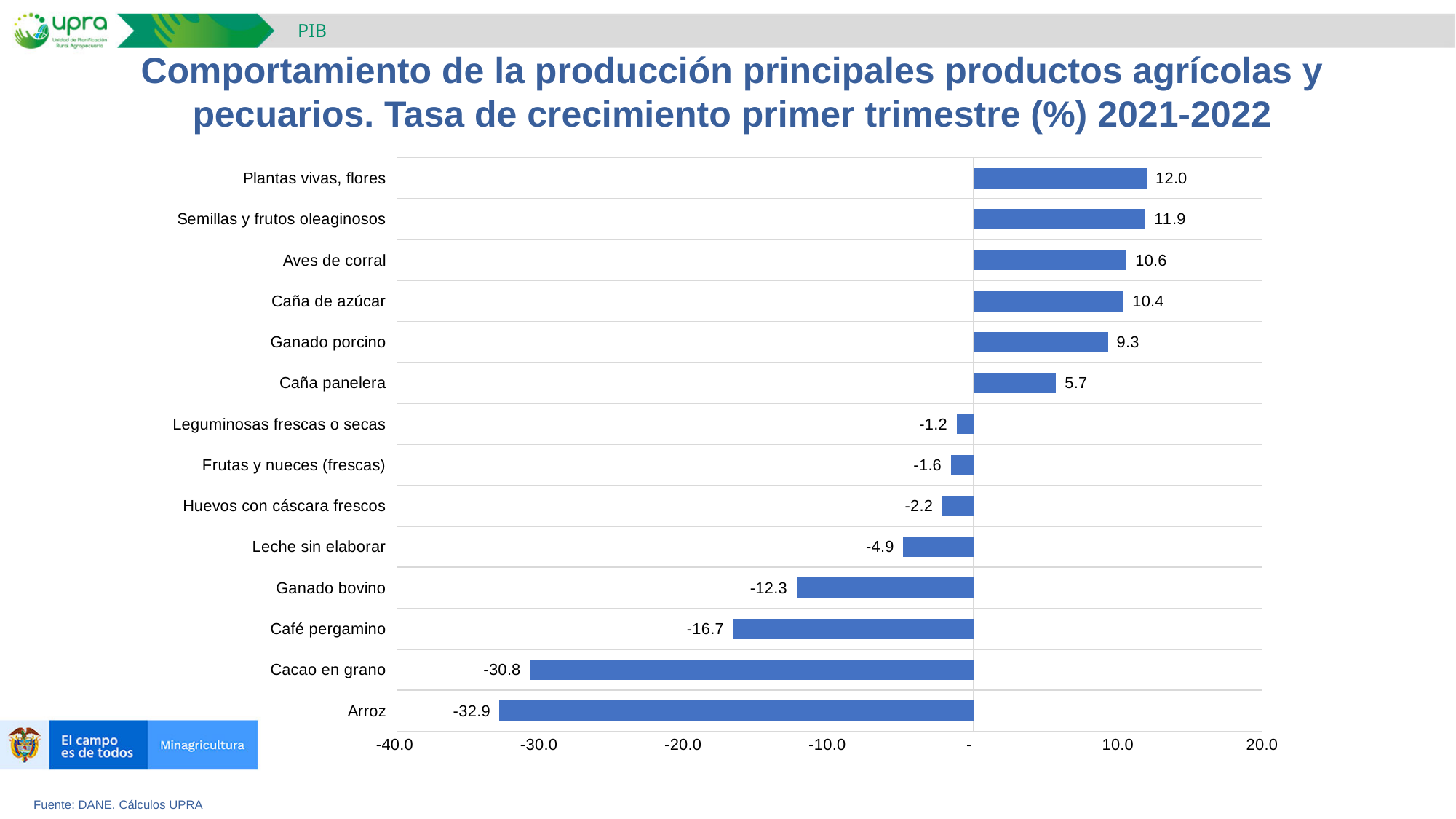
How many categories are shown in the chart? 14 What is the difference between the values for Cacao en grano and Arroz? 2.1 What is the value shown for Café pergamino? -16.7 What is the difference between the values for Plantas vivas, flores and Caña panelera? 6.3 What is the value shown for Leche sin elaborar? -4.9 Which has a larger value, Ganado porcino or Caña de azúcar? Caña de azúcar Which has a larger value, Ganado bovino or Café pergamino? Ganado bovino Which category has the highest value? Plantas vivas, flores What source is cited for the chart data? DANE. Cálculos UPRA Which category has the lowest value? Arroz What is the growth rate shown for Aves de corral? 10.6 What kind of chart is shown on the slide? Bar chart